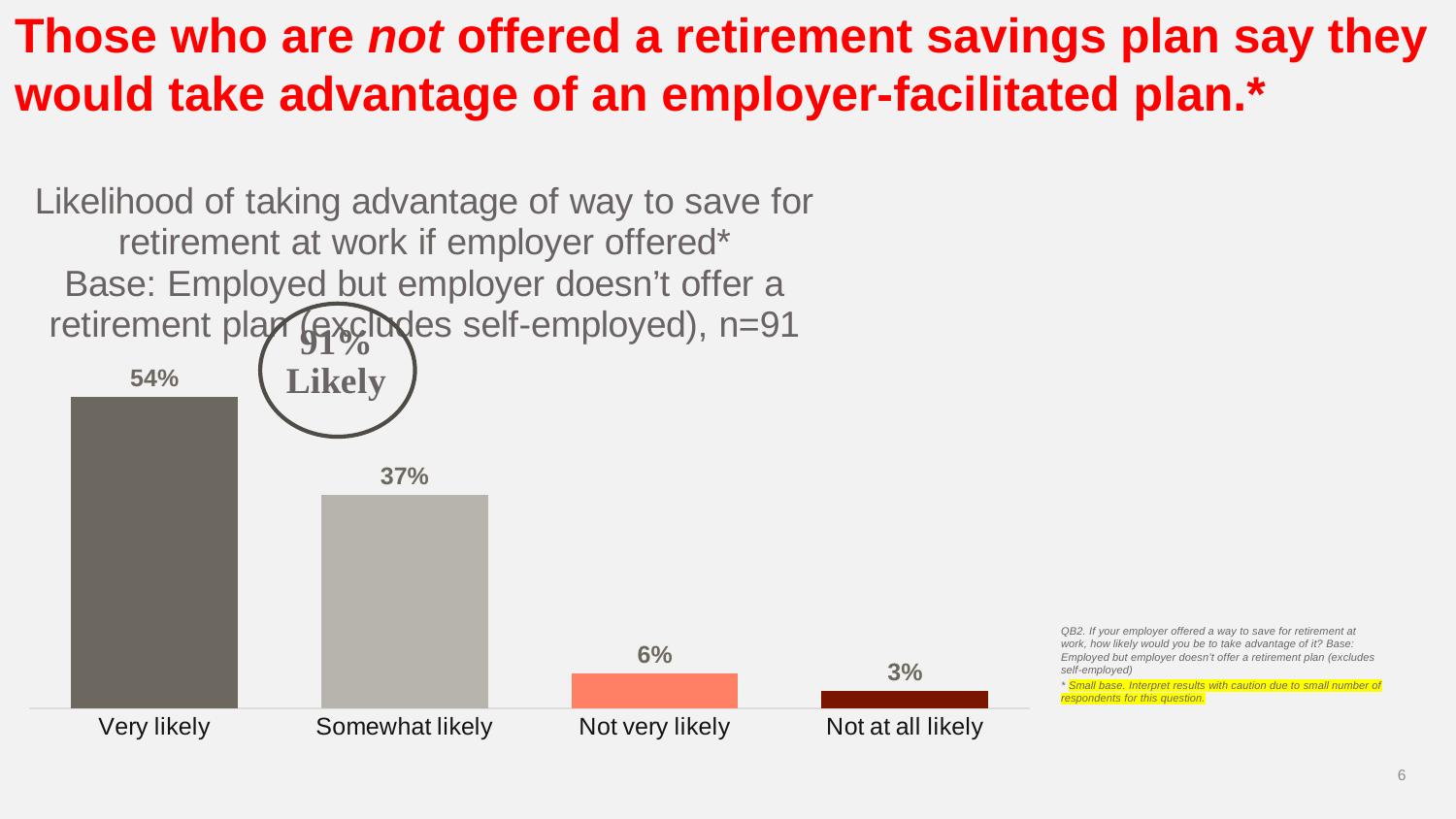
How many response categories are shown on the chart? 4 Do the values rise or fall moving from left to right across the categories? Fall What percentage of respondents said they would be very likely to take advantage of a retirement savings plan offered at work? 54% Which is larger, the value for 'Not very likely' or the value for 'Not at all likely'? Not very likely What is the value for 'Not at all likely'? 3% What combined percentage is shown in the circled callout on the chart? 91% Likely What is the difference in percentage points between 'Very likely' and 'Somewhat likely'? 17 Which response category has the lowest value? Not at all likely What type of chart is shown on the slide? Bar chart What percentage of respondents said 'Not very likely'? 6% What is the value shown for the 'Somewhat likely' bar? 37% Which response category has the highest value? Very likely